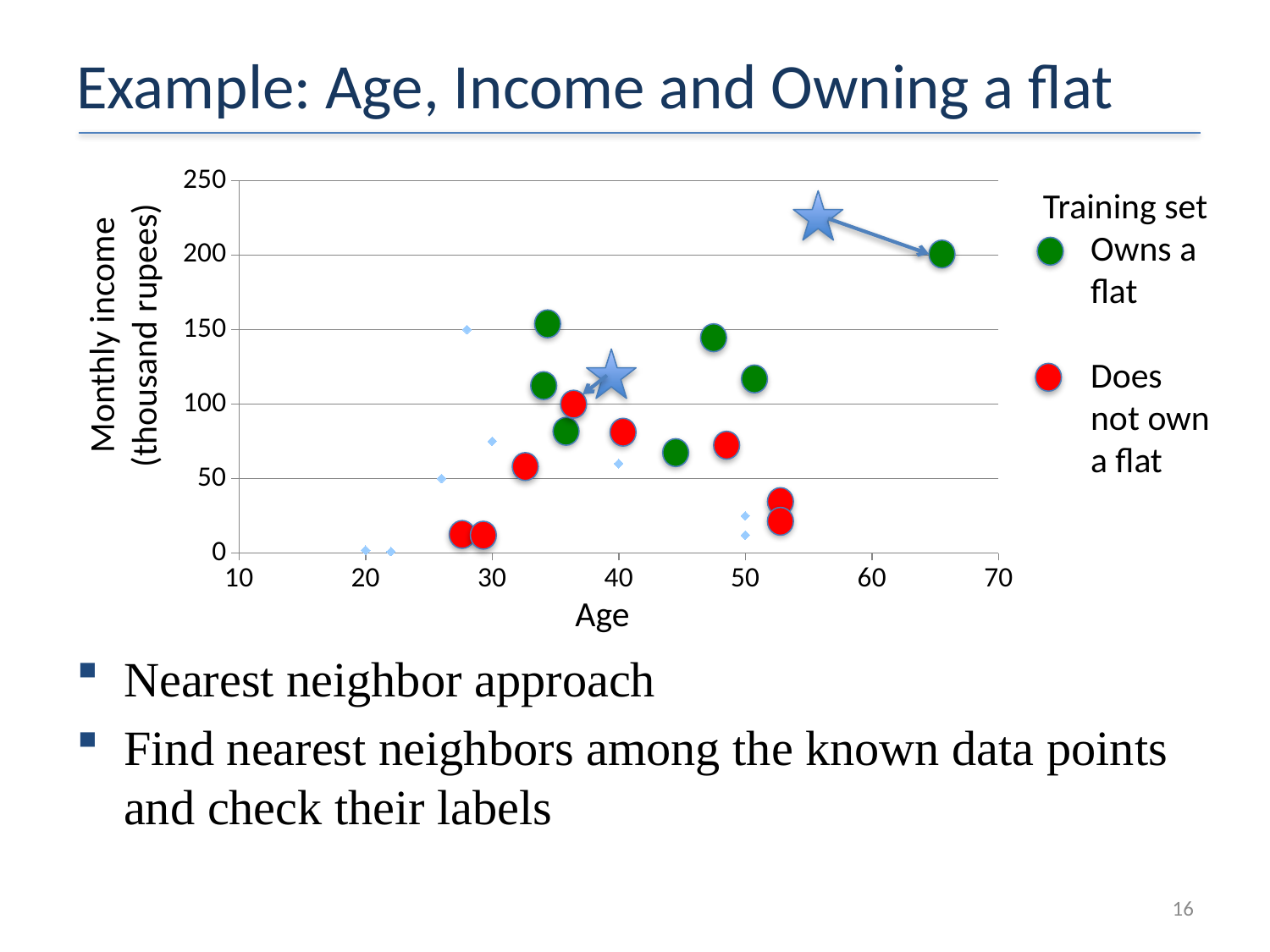
What is the title of the chart's horizontal axis? Age Is the monthly income of the green point near age 47 greater or less than 100? greater Is the monthly income of the red points near age 53 greater or less than 50? less How many categories does the legend list for the training set? 2 What kind of chart is shown on the slide? scatter chart How many red 'Does not own a flat' points are plotted on the chart? 8 Which legend category is shown with green markers? Owns a flat What is the maximum value shown on the vertical axis? 250 How many green 'Owns a flat' points are plotted on the chart? 7 Is the age of the rightmost green point greater or less than 60? greater